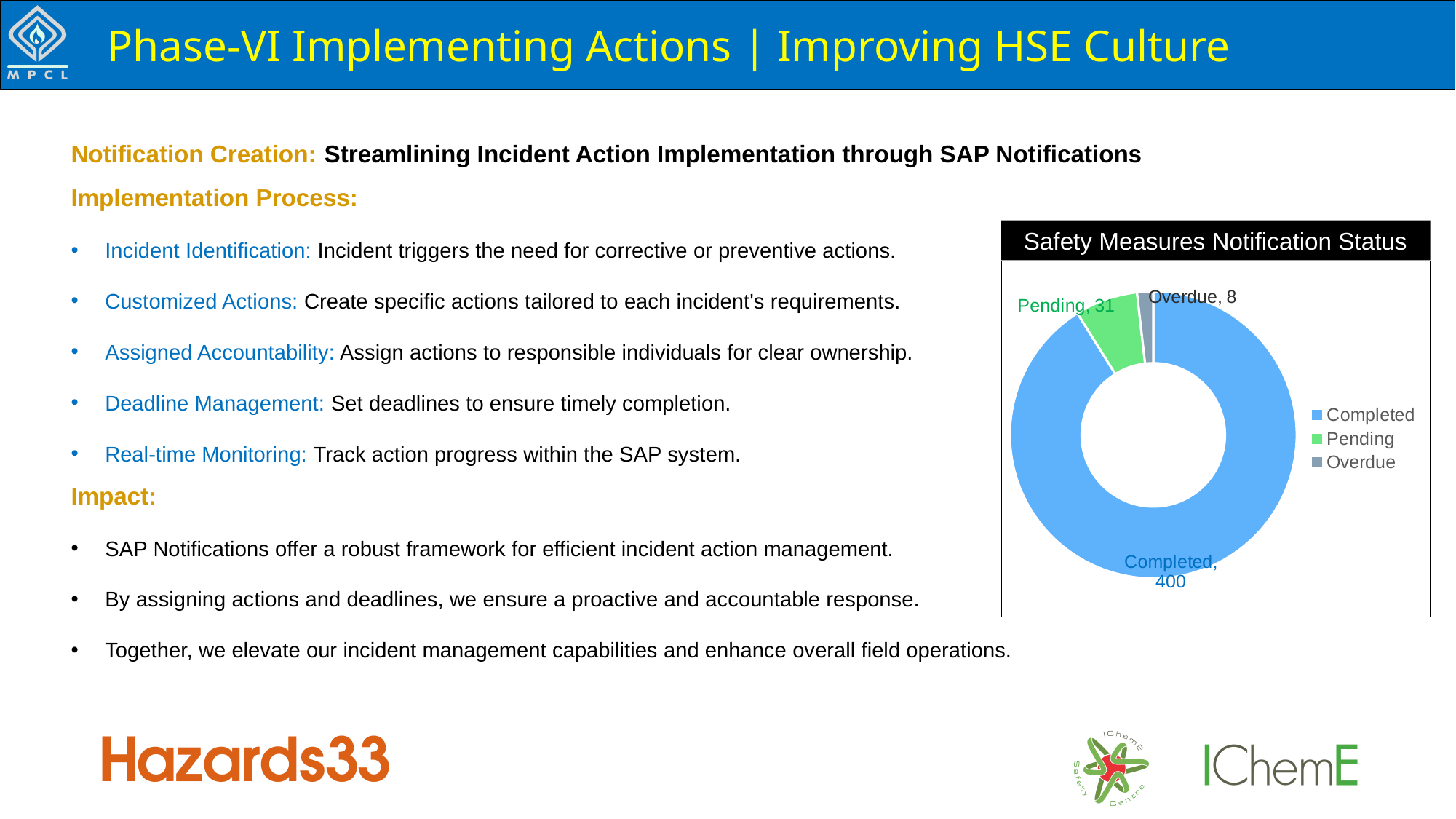
What is the difference between the Completed and Pending values in the Safety Measures Notification Status chart? 369 Which is larger in the Safety Measures Notification Status chart, Pending or Overdue? Pending How many categories are shown in the Safety Measures Notification Status chart? 3 What is the difference between the Pending and Overdue values in the Safety Measures Notification Status chart? 23 What is the value for Pending in the Safety Measures Notification Status chart? 31 What kind of chart is shown under the title 'Safety Measures Notification Status'? Doughnut chart What is the total of all values in the Safety Measures Notification Status chart? 439 Which category has the lowest value in the Safety Measures Notification Status chart? Overdue What is the value for Overdue in the Safety Measures Notification Status chart? 8 Which category has the highest value in the Safety Measures Notification Status chart? Completed What colour represents Pending in the Safety Measures Notification Status chart? Green What is the value for Completed in the Safety Measures Notification Status chart? 400